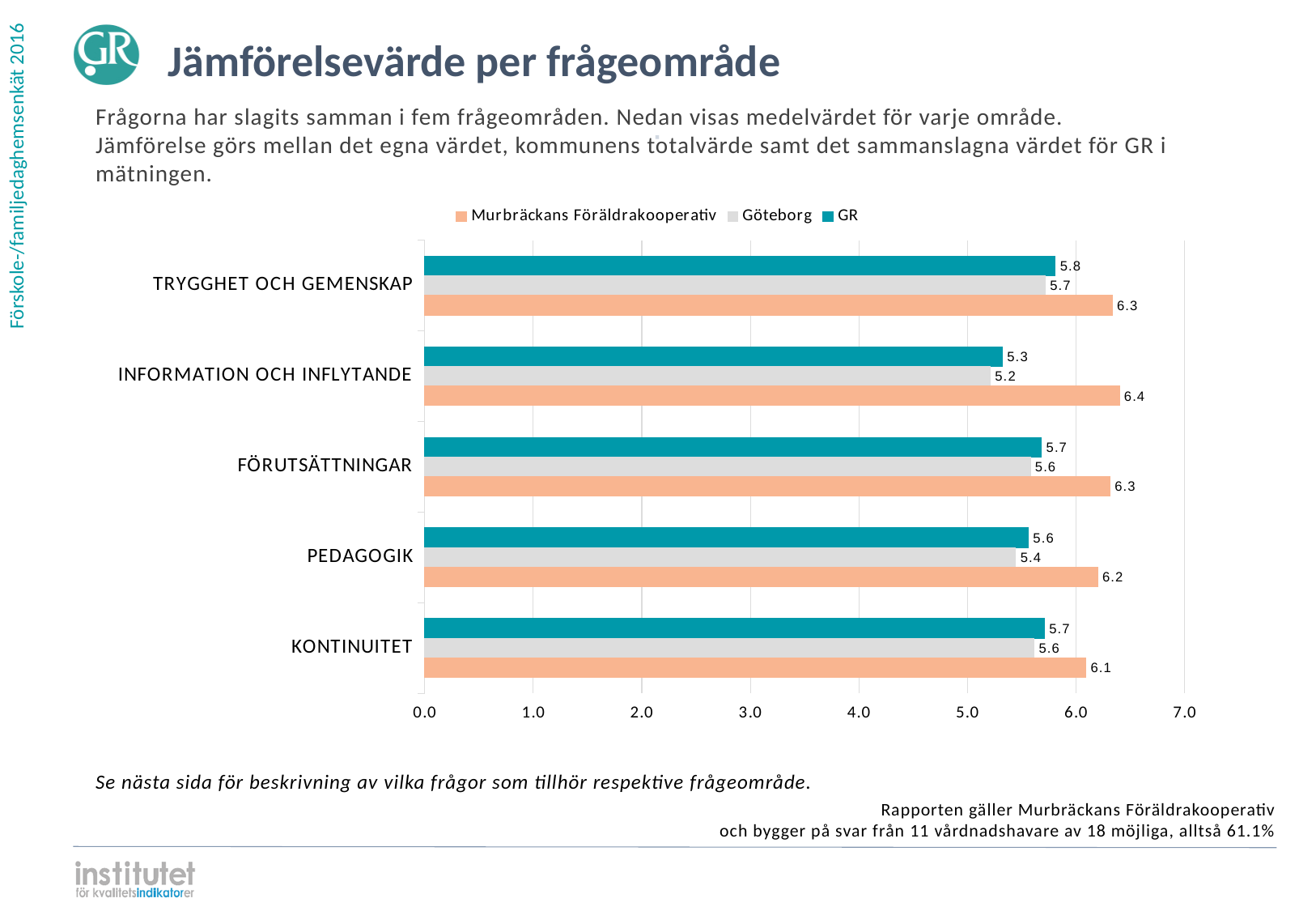
Which is larger in the PEDAGOGIK category: the value for GR or the value for Göteborg? GR How many categories are shown on the chart? 5 Which category has the lowest value for Murbräckans Föräldrakooperativ? KONTINUITET What is the value for Murbräckans Föräldrakooperativ in the INFORMATION OCH INFLYTANDE category? 6.4 Is the value for Murbräckans Föräldrakooperativ in the KONTINUITET category greater or less than 6.0? greater Which category has the lowest value for Göteborg? INFORMATION OCH INFLYTANDE What is the value for GR in the TRYGGHET OCH GEMENSKAP category? 5.8 What is the value for Göteborg in the PEDAGOGIK category? 5.4 What kind of chart is shown on the slide? bar chart Which category has the highest value for Murbräckans Föräldrakooperativ? INFORMATION OCH INFLYTANDE How many series does the legend list? 3 What is the difference between the Murbräckans Föräldrakooperativ value and the GR value in the INFORMATION OCH INFLYTANDE category? 1.1